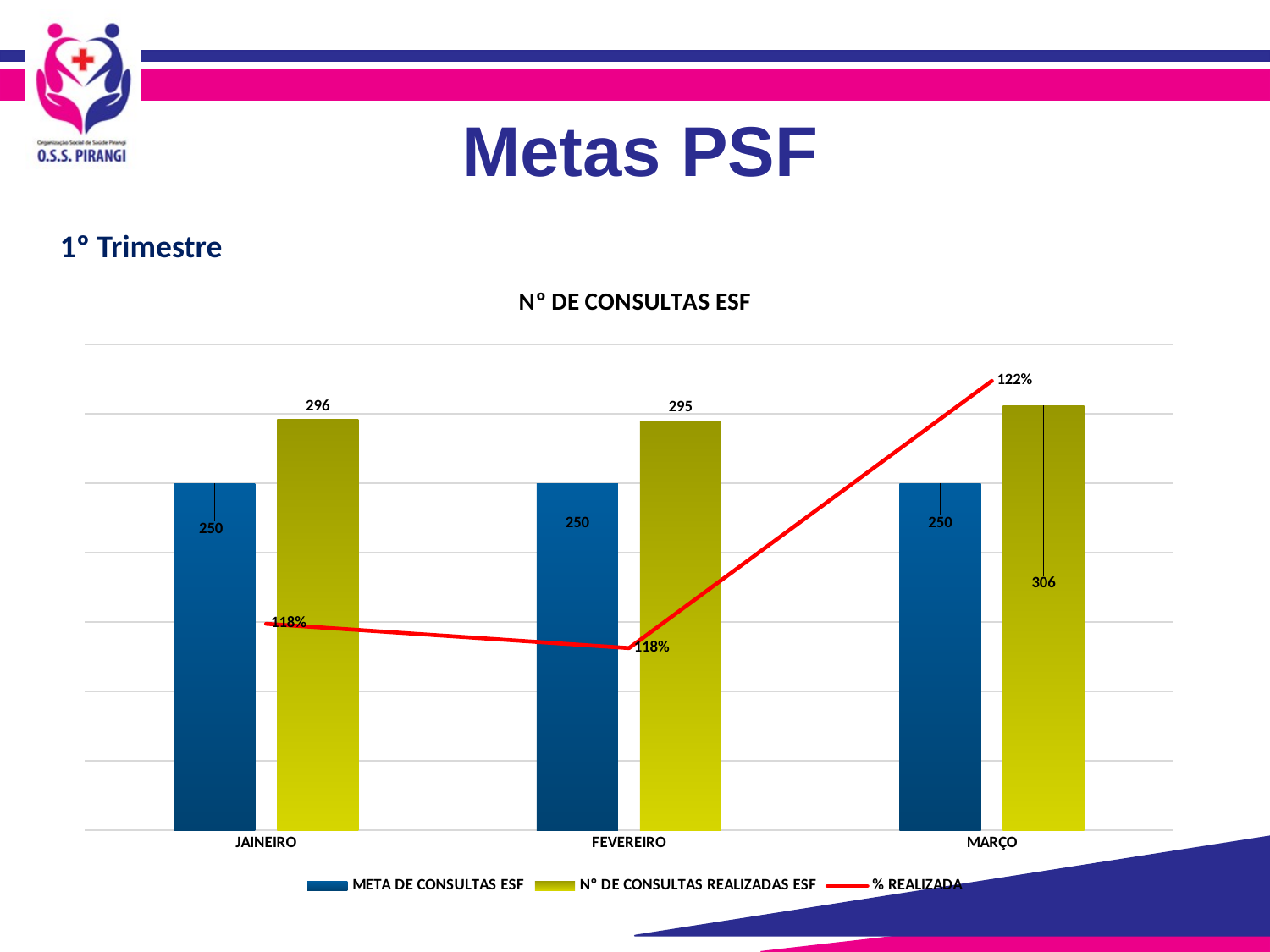
What is the value of N° DE CONSULTAS REALIZADAS ESF for MARÇO? 306 What is the difference between N° DE CONSULTAS REALIZADAS ESF and META DE CONSULTAS ESF for MARÇO? 56 How many series does the legend list? 3 What is the title of the chart? N° DE CONSULTAS ESF Which month has the lowest N° DE CONSULTAS REALIZADAS ESF? FEVEREIRO How many months are shown on the x axis? 3 Which is larger, the N° DE CONSULTAS REALIZADAS ESF for JAINEIRO or the META DE CONSULTAS ESF for JAINEIRO? N° DE CONSULTAS REALIZADAS ESF for JAINEIRO What is the difference between the N° DE CONSULTAS REALIZADAS ESF values for MARÇO and JAINEIRO? 10 What is the META DE CONSULTAS ESF value for FEVEREIRO? 250 Which month has the highest N° DE CONSULTAS REALIZADAS ESF? MARÇO What is the % REALIZADA value for MARÇO? 122% What is the value of N° DE CONSULTAS REALIZADAS ESF for JAINEIRO? 296